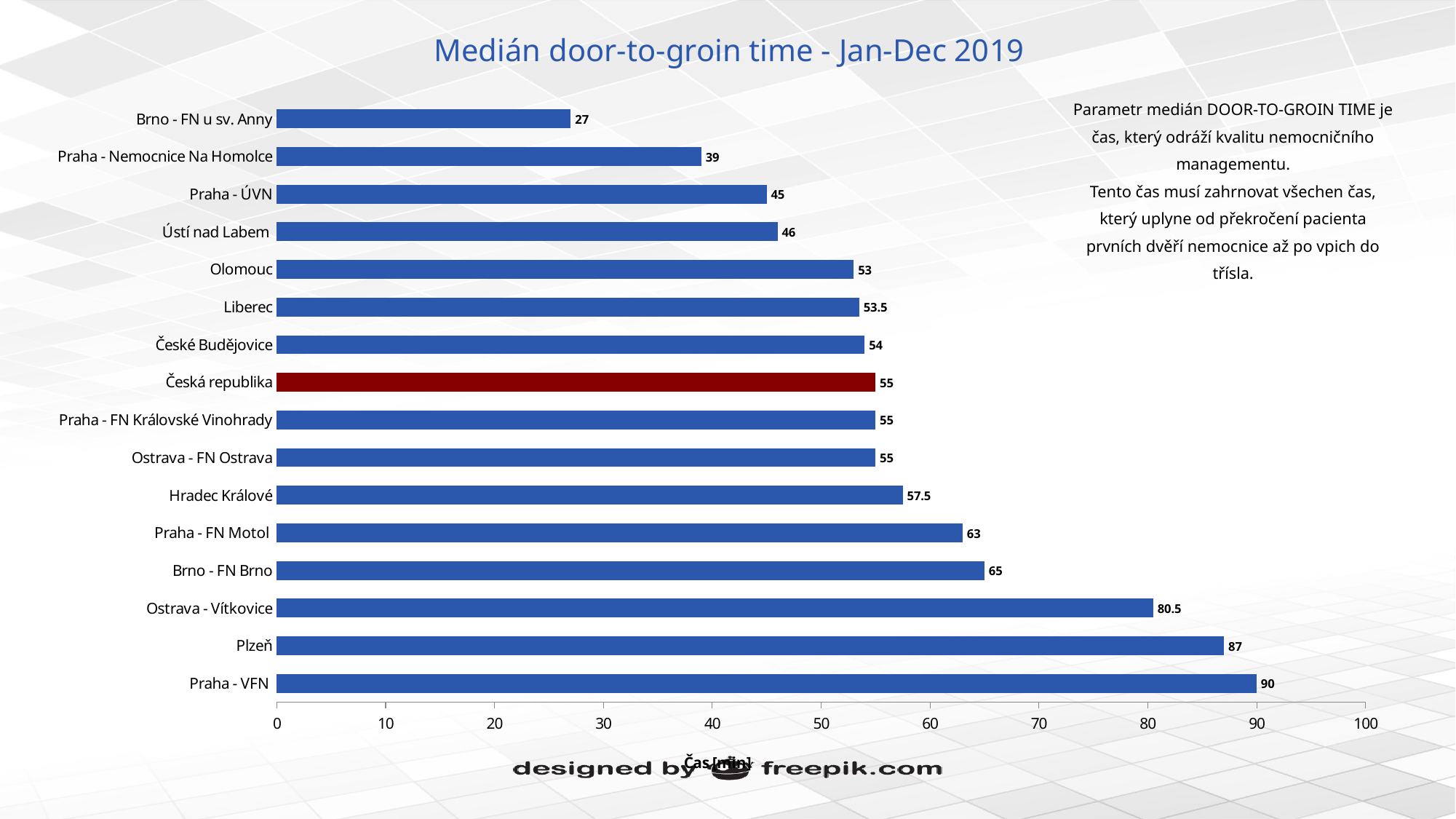
What is the value for Česká republika? 55 What is the difference between the values for Ostrava - Vítkovice and Hradec Králové? 23 Is the value for Brno - FN Brno greater or less than 60? greater What is the value shown for Liberec? 53.5 What is the median door-to-groin time for Plzeň? 87 What is the difference between the values for Praha - VFN and Brno - FN u sv. Anny? 63 Which category has the highest median door-to-groin time? Praha - VFN Which has a larger value, Praha - FN Motol or Olomouc? Praha - FN Motol How many categories are shown in the chart? 16 Which bar is coloured dark red instead of blue? Česká republika What kind of chart is shown on the slide? bar chart Which category has the lowest median door-to-groin time? Brno - FN u sv. Anny